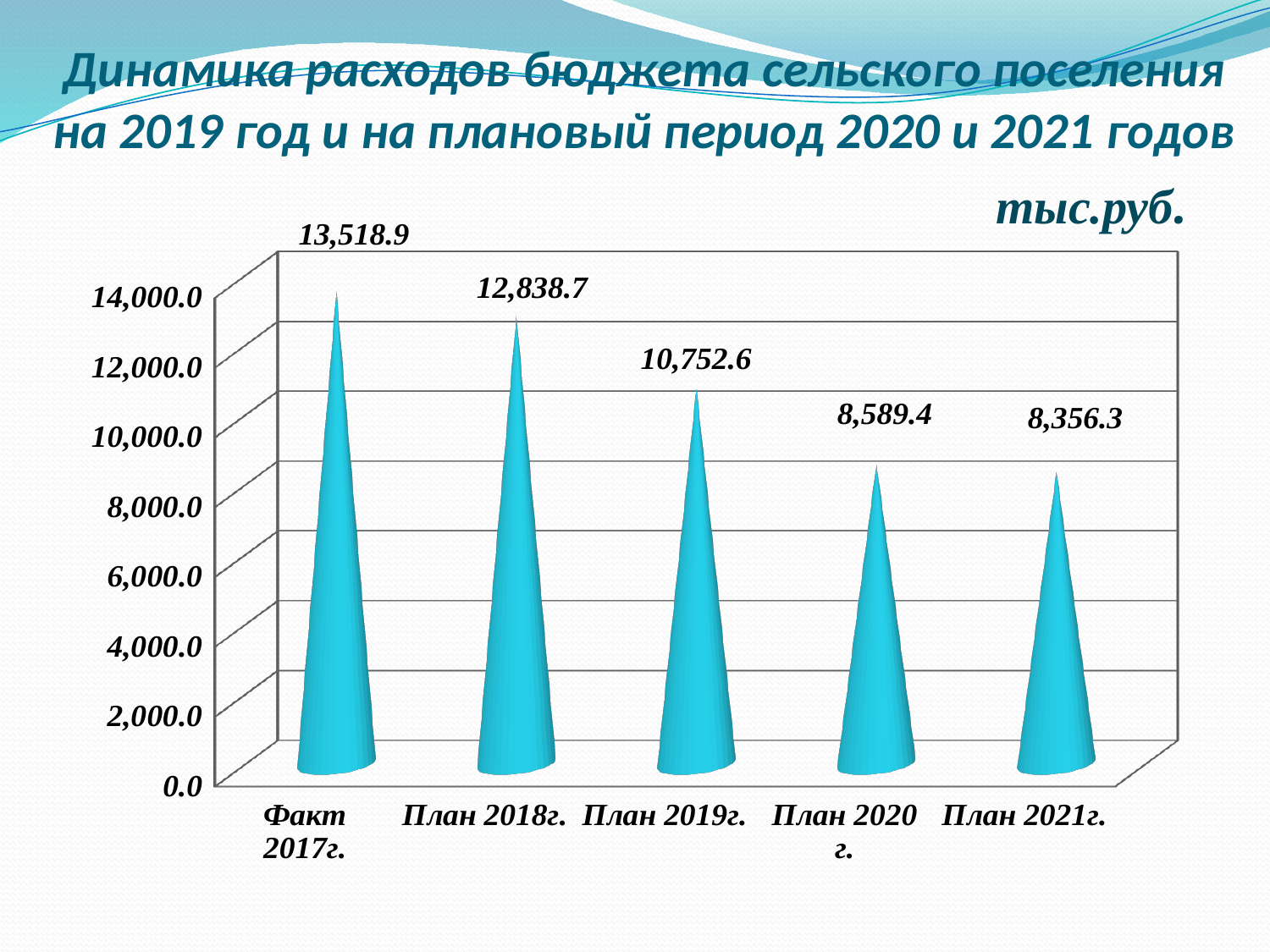
What is the difference between the values for План 2020 г. and План 2021г.? 233.1 How many categories are shown on the x axis? 5 Do the values rise or fall from left to right along the x axis? fall Which category has the lowest value? План 2021г. Which category has the highest value? Факт 2017г. Which is larger, the value for План 2018г. or the value for План 2019г.? План 2018г. What is the difference between the values for Факт 2017г. and План 2018г.? 680.2 What is the value for План 2021г.? 8,356.3 What unit of measurement is indicated for the chart values? тыс.руб. What is the value for План 2019г.? 10,752.6 Is the value for План 2020 г. greater or less than 10,000.0? less What is the value for Факт 2017г.? 13,518.9